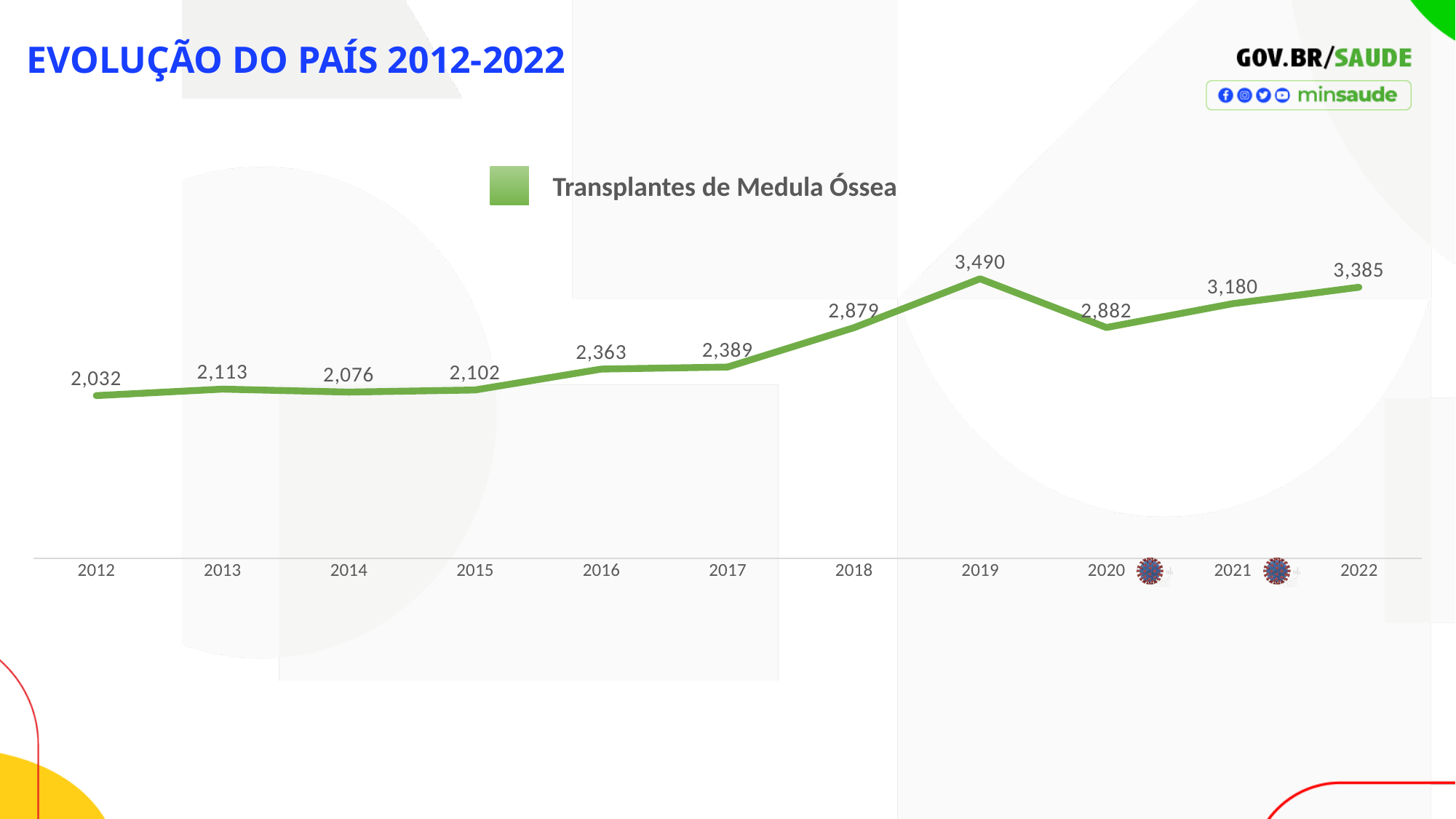
What is the value for Transplantes de Medula Óssea in 2020? 2,882 What kind of chart is shown on the slide? Line chart What is the difference between the values for 2022 and 2012? 1,353 What is the value for Transplantes de Medula Óssea in 2022? 3,385 What is the name of the series shown in the legend? Transplantes de Medula Óssea What is the difference between the values for 2019 and 2020? 608 Which year has the lowest value for Transplantes de Medula Óssea? 2012 Which year has the highest value for Transplantes de Medula Óssea? 2019 How many years are plotted on the x axis? 11 What is the value for Transplantes de Medula Óssea in 2019? 3,490 What is the value for Transplantes de Medula Óssea in 2012? 2,032 Which year has a larger value, 2018 or 2021? 2021